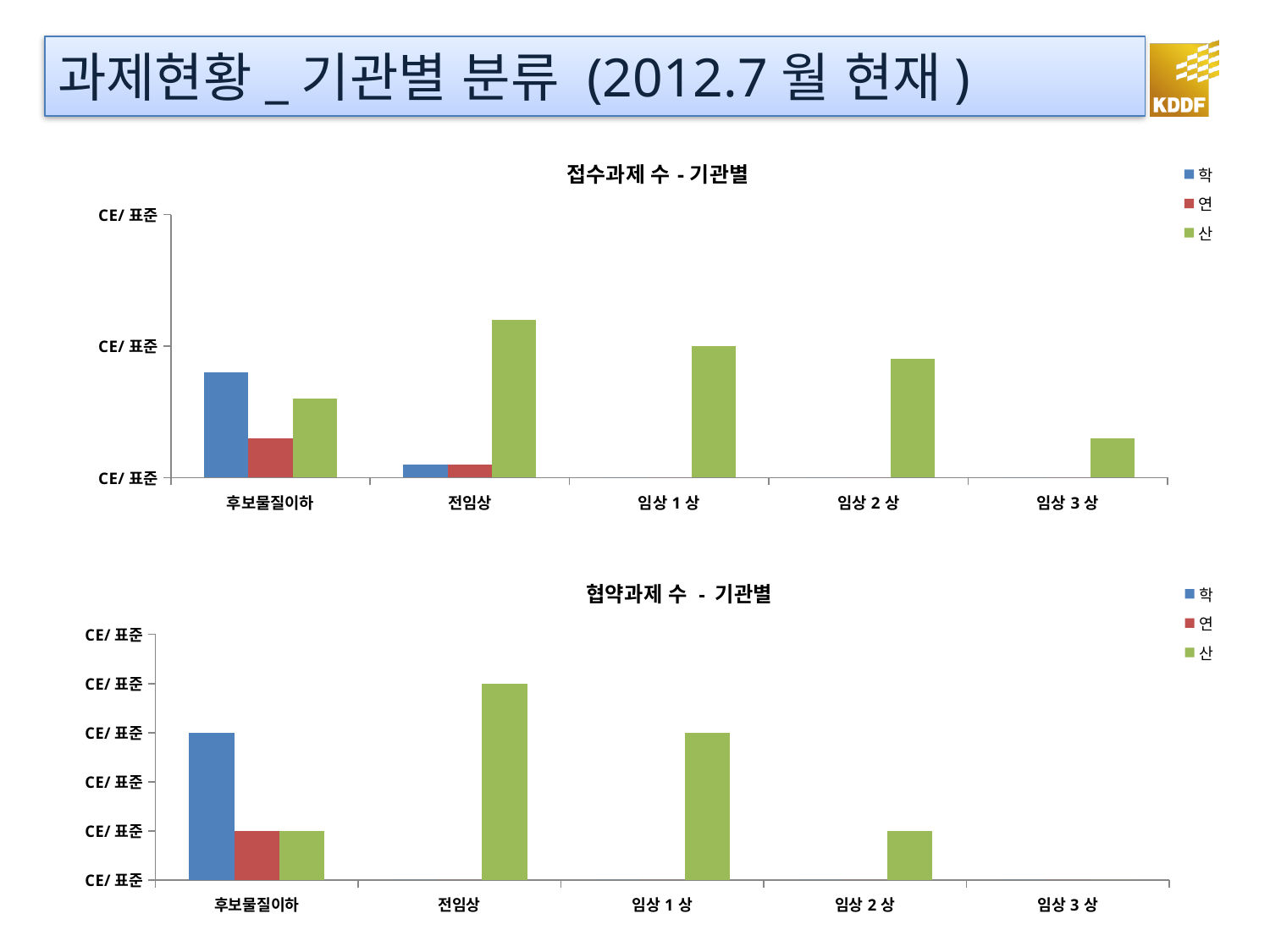
What is the title of the bottom chart? 협약과제 수 - 기관별 What kind of chart is the top chart titled 접수과제 수 - 기관별? bar chart How many categories are shown on the x axis of the top chart (접수과제 수 - 기관별)? 5 In the top chart (접수과제 수 - 기관별), which category has the lowest 산 bar? 임상 3 상 In the bottom chart (협약과제 수 - 기관별), which category has no bars at all? 임상 3 상 How many series does the legend of the top chart (접수과제 수 - 기관별) list? 3 In the top chart (접수과제 수 - 기관별), is the 학 bar for 후보물질이하 larger or smaller than the 학 bar for 전임상? larger In the top chart (접수과제 수 - 기관별), which category has the highest 산 bar? 전임상 In the top chart (접수과제 수 - 기관별), which series is shown in green? 산 In the bottom chart (협약과제 수 - 기관별), do the 산 bars rise or fall from 전임상 to 임상 3 상? fall In the bottom chart (협약과제 수 - 기관별), is the 산 bar for 전임상 larger or smaller than the 산 bar for 임상 1 상? larger In the bottom chart (협약과제 수 - 기관별), which category has the highest 산 bar? 전임상